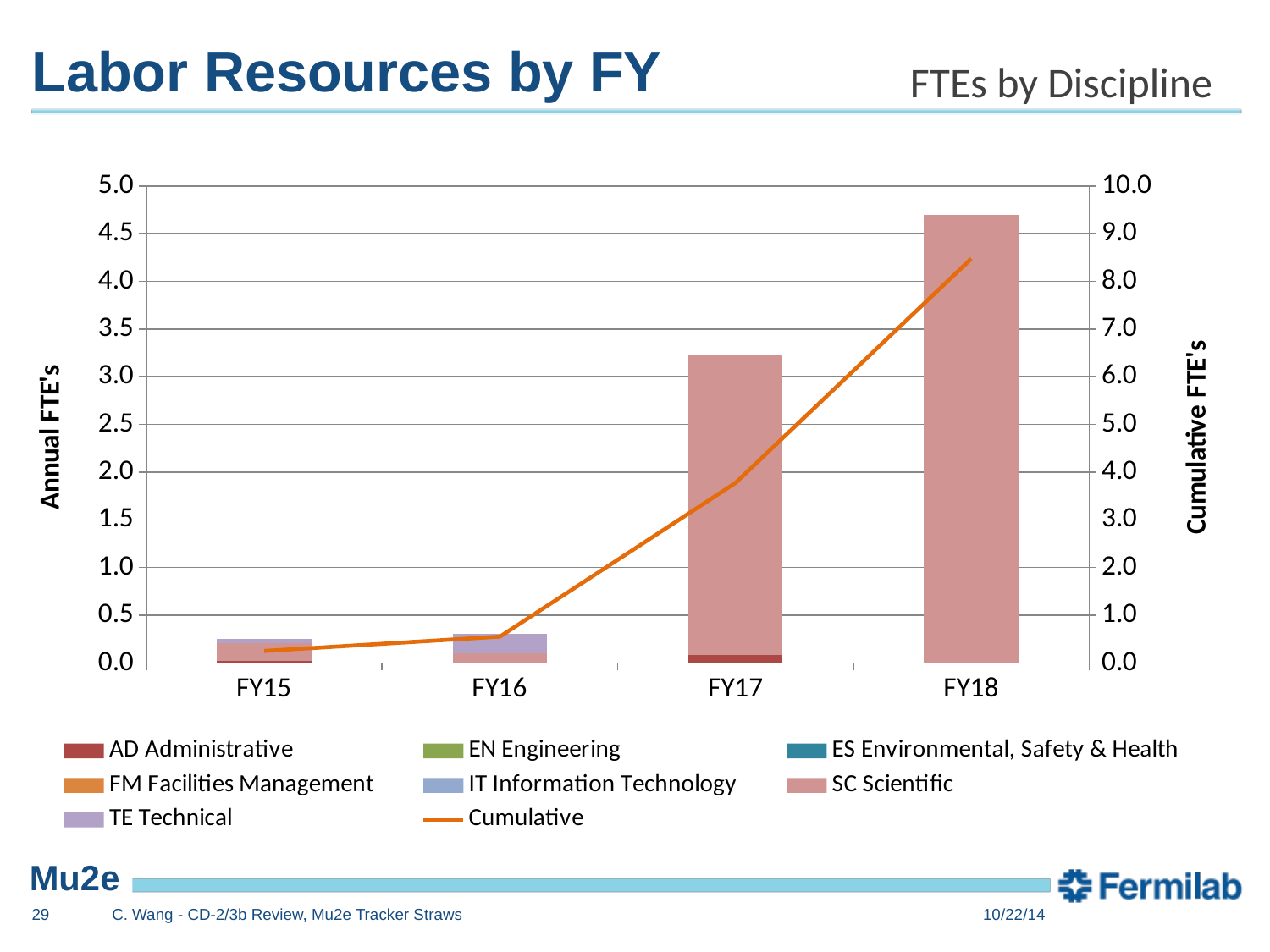
Is the total annual FTE value for FY18 greater or less than 4.0? greater How many entries does the legend list? 8 Is the total annual FTE value for FY15 greater or less than 0.5? less How many fiscal years are shown on the x axis? 4 What is the title of the right-hand vertical axis? Cumulative FTE's What kind of chart is shown on the slide? Bar chart with a line Which fiscal year has the shortest stacked bar? FY15 Which has the larger stacked bar, FY16 or FY17? FY17 Which fiscal year has the tallest stacked bar? FY18 Does the Cumulative line rise or fall from FY15 to FY18? Rises Is the total annual FTE value for FY17 greater or less than 3.0? greater